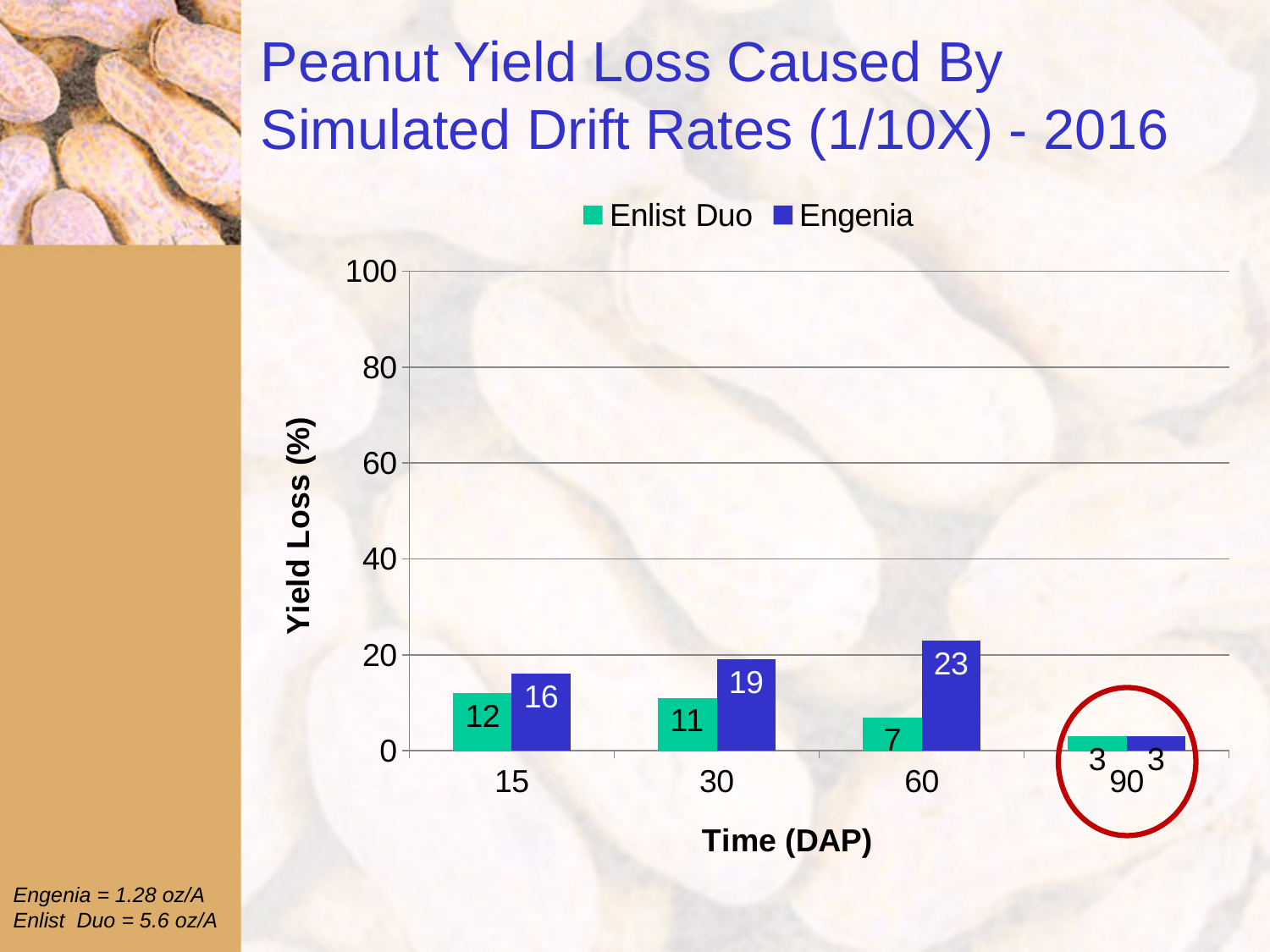
At which time (DAP) is the Enlist Duo yield loss lowest? 90 What kind of chart is shown on the slide? Bar chart What is the yield loss for Enlist Duo at 15 DAP? 12 How many time (DAP) categories are shown on the x axis? 4 At 30 DAP, which product has the larger yield loss, Enlist Duo or Engenia? Engenia What is the yield loss for Enlist Duo at 30 DAP? 11 How many series does the legend list? 2 What is the difference between the Engenia and Enlist Duo yield loss at 60 DAP? 16 What is the yield loss for Engenia at 60 DAP? 23 Is the Engenia yield loss at 60 DAP greater or less than 20? greater Does the Enlist Duo yield loss rise or fall as time (DAP) increases from 15 to 90? Fall At which time (DAP) is the Engenia yield loss highest? 60